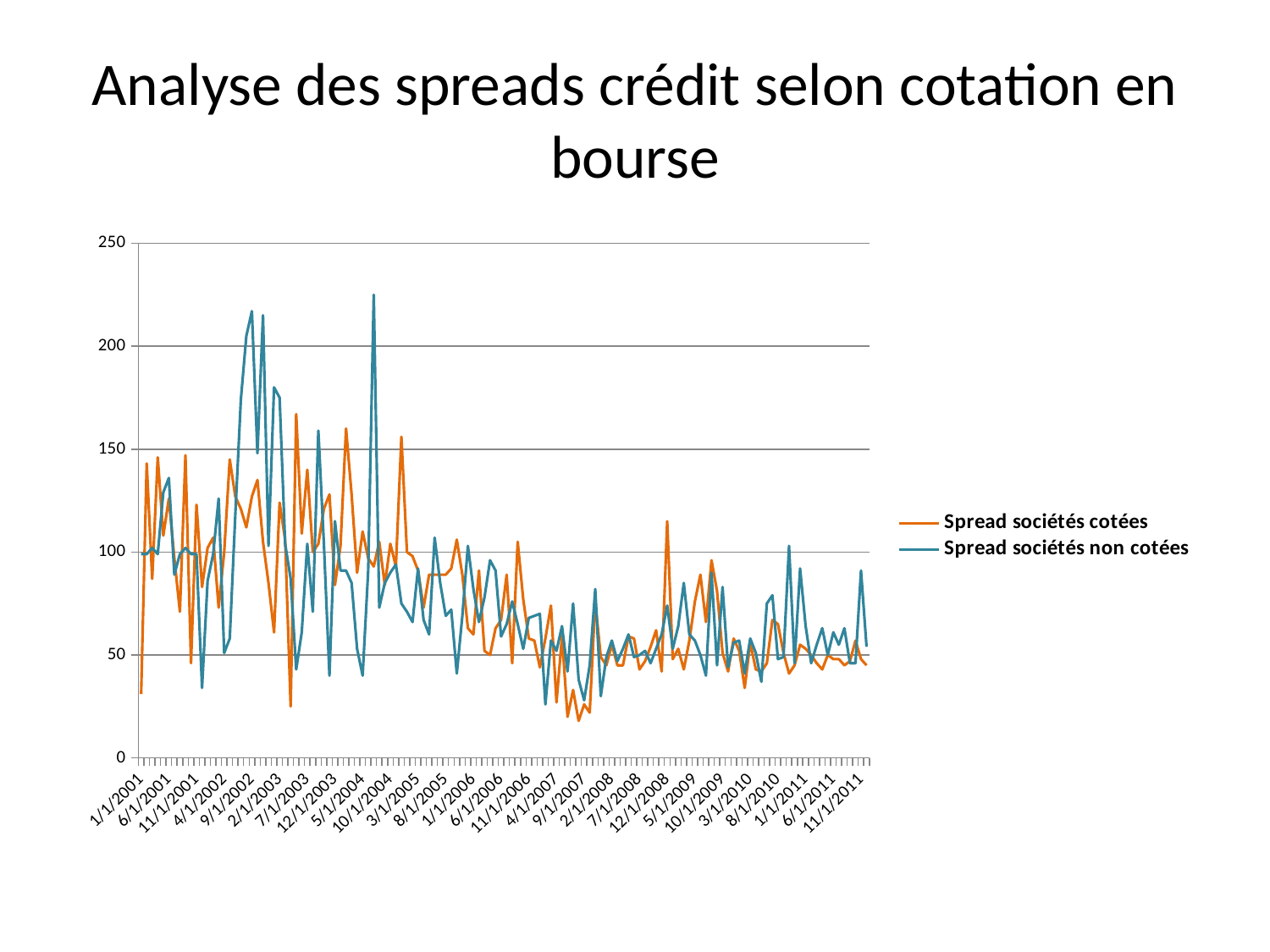
What are the two series named in the legend? Spread sociétés cotées; Spread sociétés non cotées Which series reaches the highest peak on the chart? Spread sociétés non cotées Is the value for 'Spread sociétés non cotées' at 1/1/2001 greater or less than 50? greater Is the highest value of 'Spread sociétés cotées' greater or less than 200? less Which colour is used for the 'Spread sociétés non cotées' line? blue Overall, do the spread values rise or fall from 2002-2003 to 2011? fall How many series does the legend list? 2 Is the highest value of 'Spread sociétés non cotées' greater or less than 200? greater What is the highest value shown on the vertical axis? 250 What kind of chart is shown on the slide? line chart